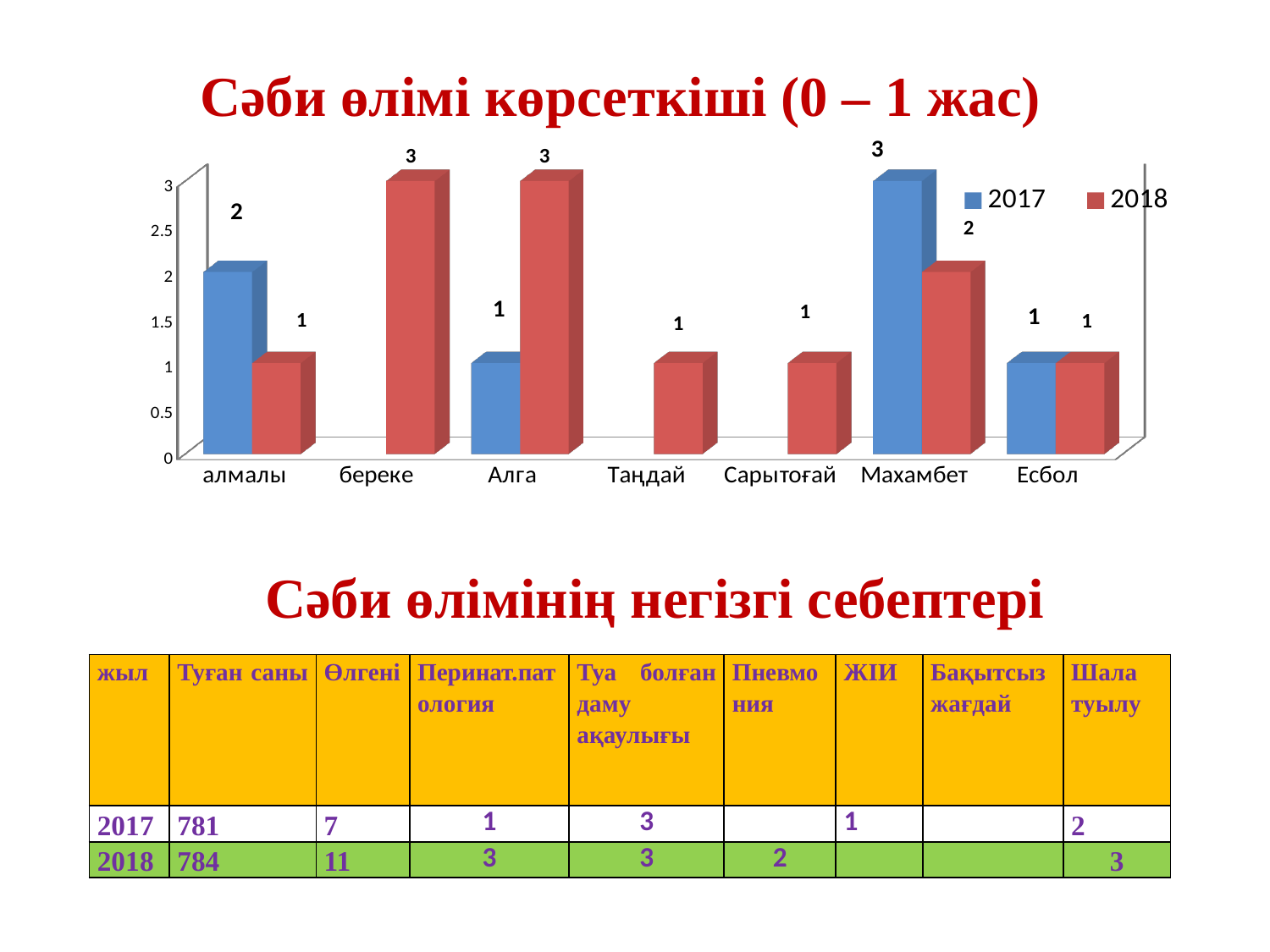
What is the title of the chart? Сәби өлімі көрсеткіші (0 – 1 жас) What is the 2018 value for береке? 3 How many categories are shown on the x axis of the chart? 7 How many series does the chart legend list? 2 What is the 2017 value for алмалы? 2 What is the 2017 value for Махамбет? 3 What type of chart is shown on the slide? bar chart What is the 2018 value for Алга? 3 Which category has the highest 2017 value? Махамбет Which is larger for Махамбет, the 2017 value or the 2018 value? 2017 What is the difference between the 2018 and 2017 values for Алга? 2 What is the difference between the 2017 and 2018 values for алмалы? 1